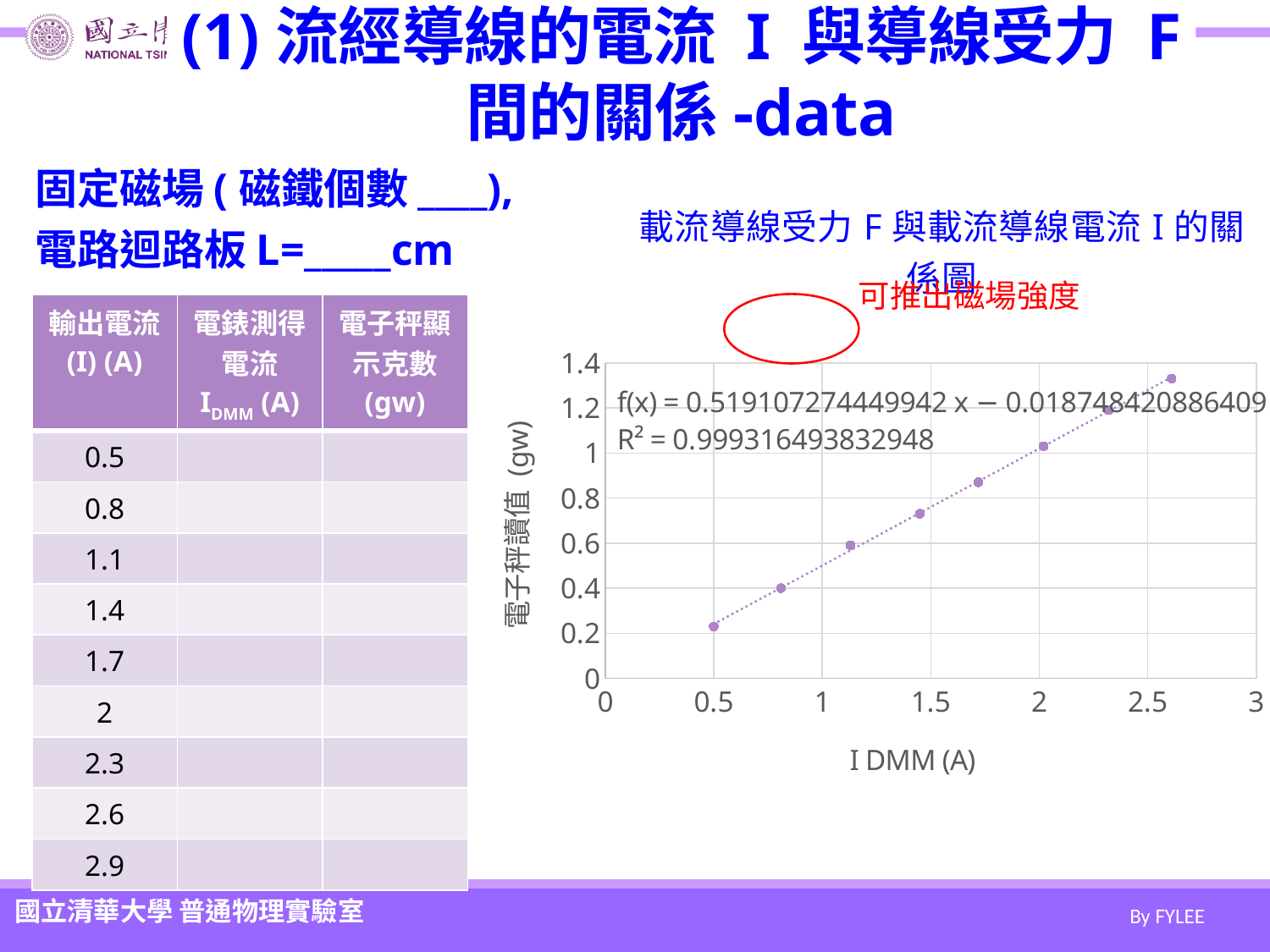
What R² value is shown on the chart? 0.999316493832948 Do the electronic balance readings rise or fall as I DMM increases along the x axis? rise How many data points are plotted in the chart? 8 What is the label of the y axis of the chart? 電子秤讀值 (gw) Is the balance reading for the rightmost data point (near 2.6 A) greater or less than 1.2 gw? greater Is the balance reading for the data point near 1.7 A greater or less than 0.8 gw? greater What is the slope of the fitted trendline equation shown on the chart? 0.519107274449942 Which data point has the larger balance reading, the leftmost one or the rightmost one? the rightmost one Is the balance reading for the leftmost data point (near 0.5 A) greater or less than 0.4 gw? less What kind of chart is shown on the slide? scatter chart What is the label of the x axis of the chart? I DMM (A)